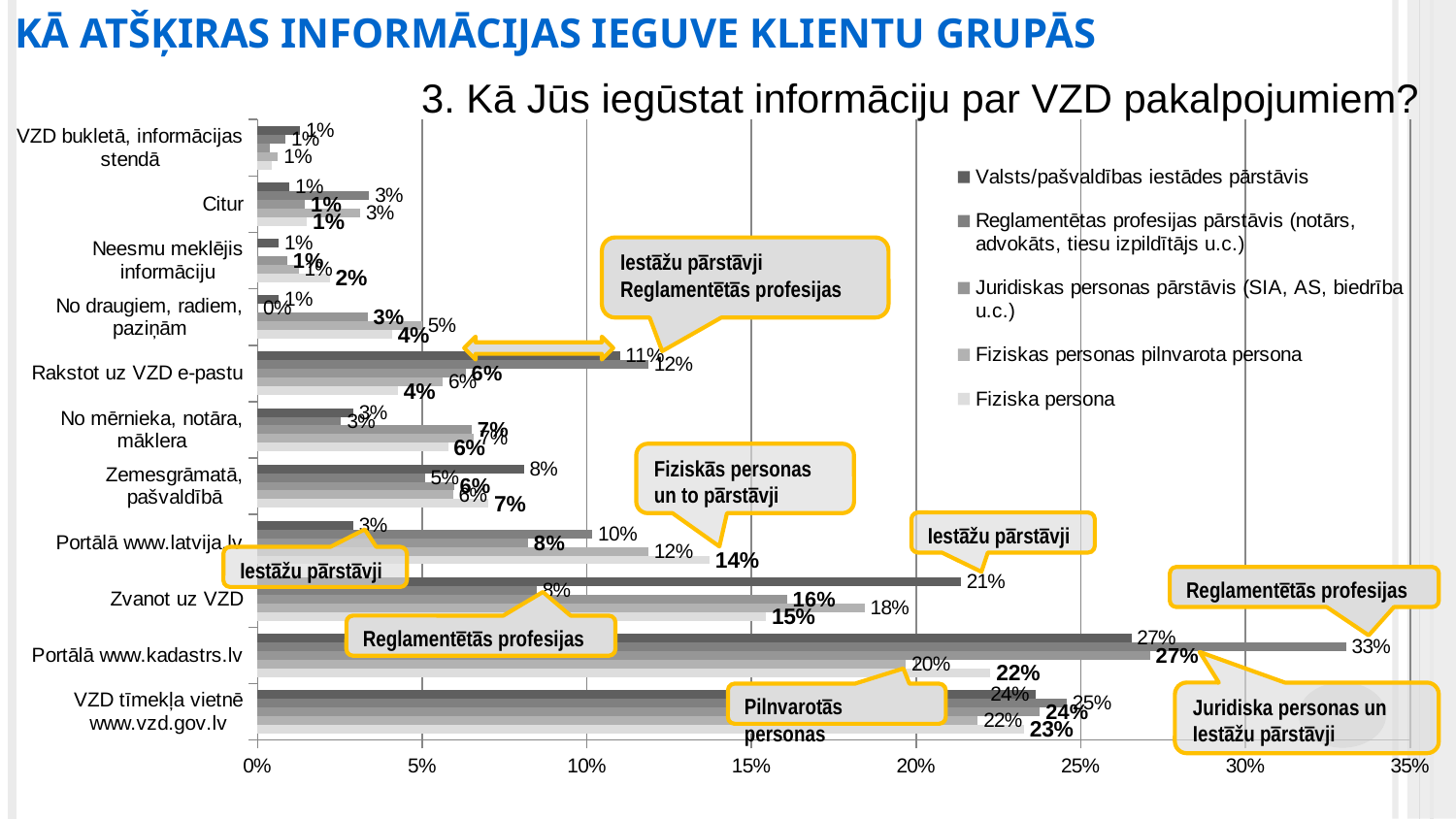
What is the value for Fiziskas personas pilnvarota persona in the category Portālā www.kadastrs.lv? 20% What is the value for Valsts/pašvaldības iestādes pārstāvis in the category Zvanot uz VZD? 21% How many series does the legend list? 5 Which category has the highest value for Reglamentētas profesijas pārstāvis? Portālā www.kadastrs.lv What is the question title shown above the chart? 3. Kā Jūs iegūstat informāciju par VZD pakalpojumiem? How many categories (information sources) are shown on the vertical axis? 11 What kind of chart is shown on the slide? Bar chart Is the value for Valsts/pašvaldības iestādes pārstāvis in the category Zvanot uz VZD greater or less than 20%? greater In the category Zvanot uz VZD, which is larger: the value for Valsts/pašvaldības iestādes pārstāvis or for Reglamentētas profesijas pārstāvis? Valsts/pašvaldības iestādes pārstāvis What is the value for Reglamentētas profesijas pārstāvis in the category Portālā www.kadastrs.lv? 33% In the category Portālā www.kadastrs.lv, what is the difference between the value for Reglamentētas profesijas pārstāvis (33%) and Fiziskas personas pilnvarota persona (20%)? 13 percentage points What is the value for Fiziska persona in the category Portālā www.latvija.lv? 14%